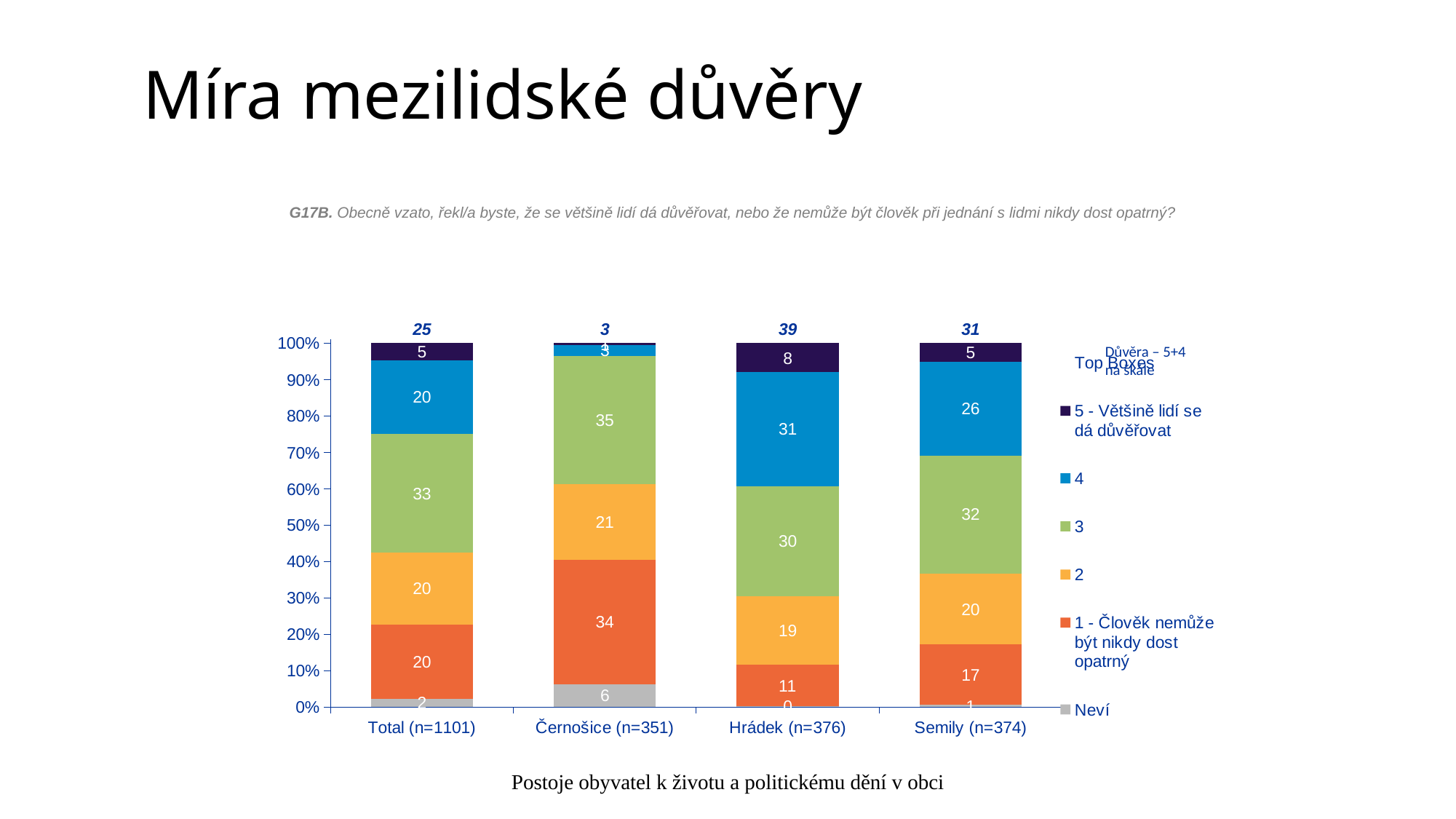
What is the value of series '3' for Semily (n=374)? 32 What is the Top Boxes value shown above the bar for Total (n=1101)? 25 How many series does the legend list? 6 What is the question text (G17B) shown above the chart? Obecně vzato, řekl/a byste, že se většině lidí dá důvěřovat, nebo že nemůže být člověk při jednání s lidmi nikdy dost opatrný? What is the difference between the '5 - Většině lidí se dá důvěřovat' values for Hrádek (n=376) and Semily (n=374)? 3 What is the value of series '4' for Hrádek (n=376)? 31 Which category has the highest Top Boxes value shown above the bars? Hrádek (n=376) How many categories (bars) are shown on the x axis? 4 What is the value of series '1 - Člověk nemůže být nikdy dost opatrný' for Černošice (n=351)? 34 Which is larger: the '2' value for Černošice (n=351) or the '2' value for Hrádek (n=376)? Černošice (n=351) What kind of chart is shown on the slide? stacked bar chart Which category has the lowest Top Boxes value shown above the bars? Černošice (n=351)